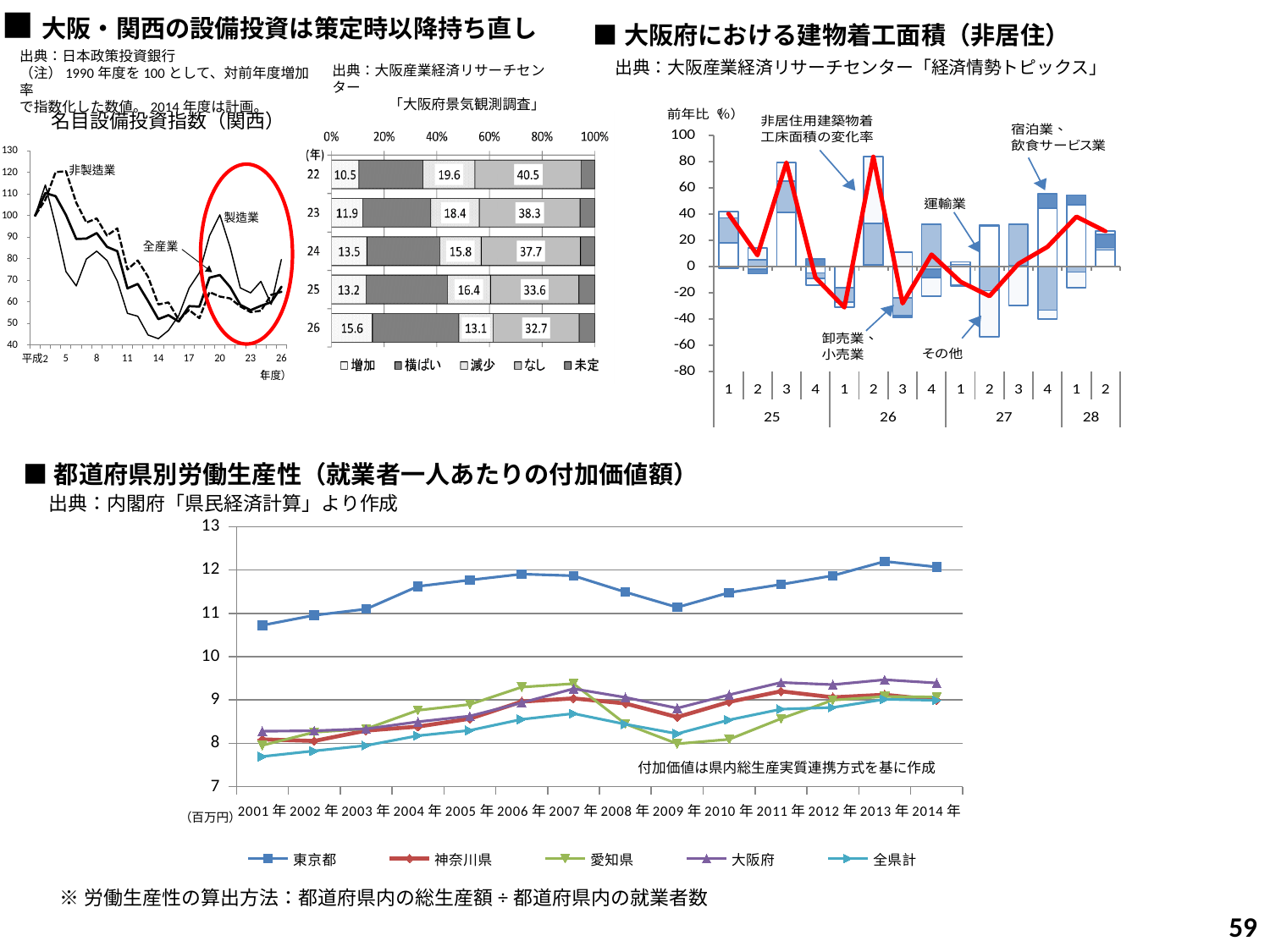
What kind of chart is the 都道府県別労働生産性 chart? line chart In the 大阪府景気観測調査 chart, does the 増加 value rise or fall from year 22 to year 26? rise In the 大阪府景気観測調査 chart, what is the 増加 value for year 26? 15.6 In the 都道府県別労働生産性 chart, which series has the highest values throughout? 東京都 In the 名目設備投資指数（関西） chart, how many series are plotted? 3 In the 大阪府景気観測調査 chart, how many years (categories) are shown? 5 In the 都道府県別労働生産性 chart, how many prefectures/series does the legend list? 5 In the 大阪府景気観測調査 chart, what is the 増加 value for year 22? 10.5 In the 都道府県別労働生産性 chart, is the value for 東京都 in 2013 greater or less than 12? greater In the 都道府県別労働生産性 chart, how many years are shown on the x axis? 14 In the 大阪府景気観測調査 chart, how many categories does the legend list? 5 In the 都道府県別労働生産性 chart, is the value for 東京都 in 2001 greater or less than 11? less